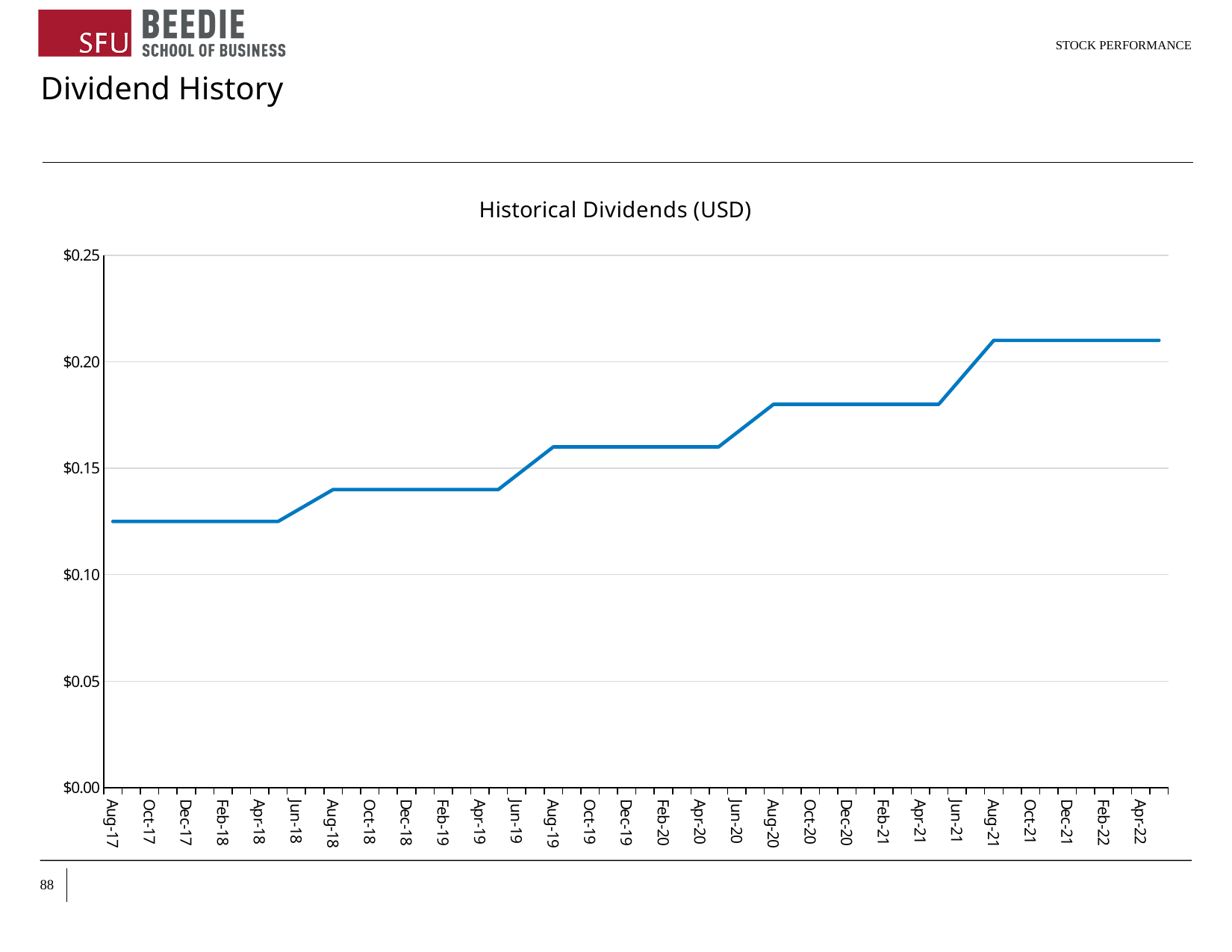
Which has the larger dividend value, Aug-17 or Apr-22? Apr-22 Is the dividend value for Aug-17 greater or less than $0.15? less Is the dividend value for Aug-20 greater or less than $0.20? less Which has the larger dividend value, Aug-18 or Aug-20? Aug-20 Is the dividend value for Aug-19 greater or less than $0.15? greater What type of chart is shown on the slide? Line chart What is the title of the chart? Historical Dividends (USD) What is the highest value shown on the y axis? $0.25 Do the dividend values generally rise or fall from Aug-17 to Apr-22? Rise